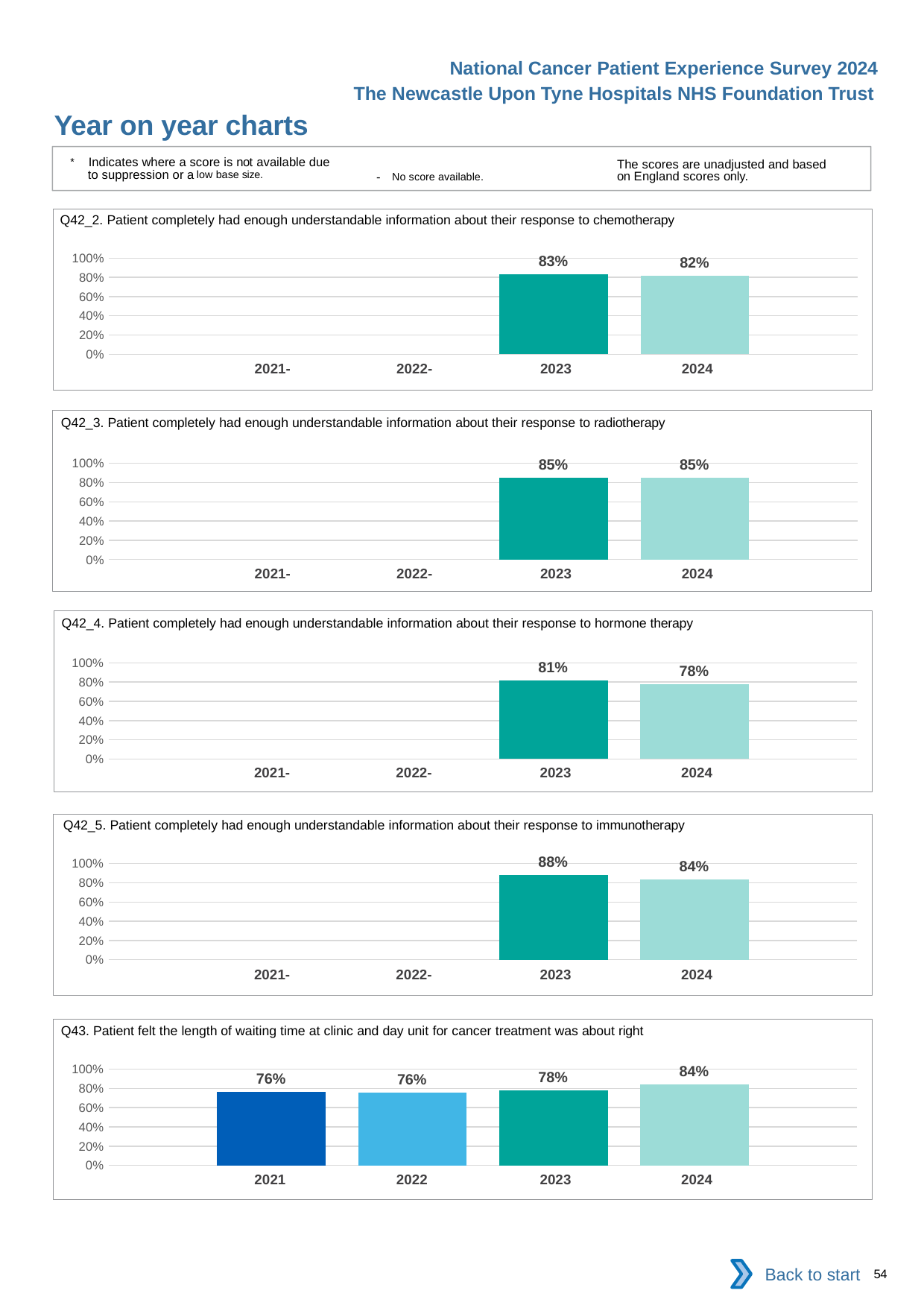
In the Q42_5 chart (immunotherapy), what is the difference between the 2023 and 2024 values? 4% In the Q42_4 chart (hormone therapy), which year has the higher value, 2023 or 2024? 2023 In the Q42_5 chart (immunotherapy), what is the value for 2023? 88% In the Q43 chart (waiting time at clinic and day unit), do the values rise or fall from 2022 to 2024? rise In the Q42_2 chart (chemotherapy), what is the value for 2024? 82% In the Q43 chart (waiting time at clinic and day unit), what is the value for 2022? 76% In the Q42_3 chart (radiotherapy), what is the value for 2023? 85% In the Q42_4 chart (hormone therapy), what is the value for 2024? 78% In the Q42_2 chart (chemotherapy), what is the difference between the 2023 and 2024 values? 1% In the Q42_3 chart (radiotherapy), how many years have a score plotted? 2 What kind of chart is the Q43 chart (waiting time at clinic and day unit)? bar chart In the Q43 chart (waiting time at clinic and day unit), which year has the highest value? 2024